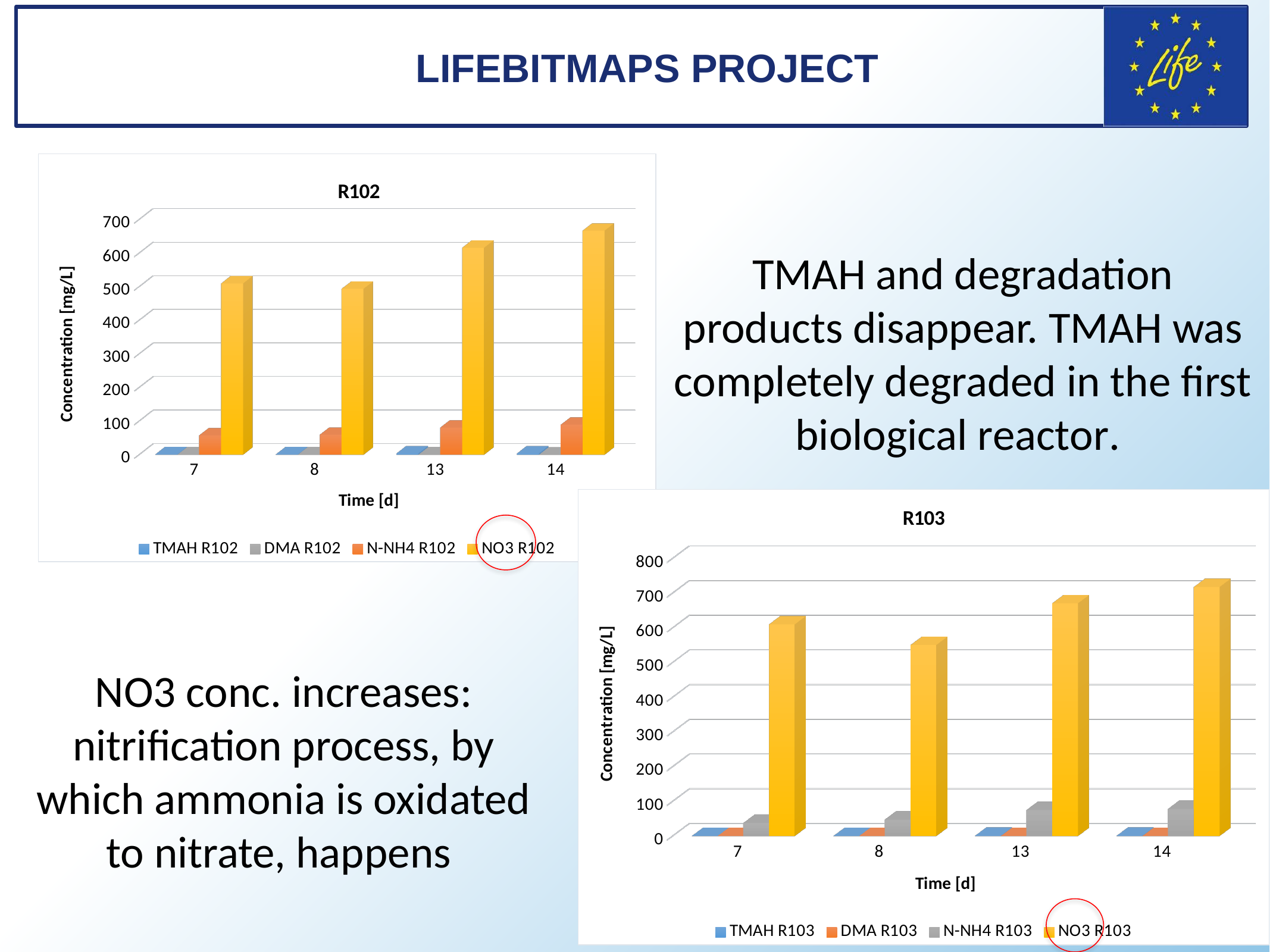
In the R103 chart, at which time is the NO3 R103 value highest? 14 How many time points are shown on the x axis of the R103 chart? 4 In the R103 chart, is the NO3 R103 value at time 8 greater or less than 400? greater In the R103 chart, at which time is the NO3 R103 value lowest? 8 What is the y-axis label of the R103 chart? Concentration [mg/L] What type of chart is the R102 chart? bar chart In the R102 chart, at which time is the NO3 R102 value highest? 14 In the R103 chart, is the NO3 R103 value at time 14 greater or less than 600? greater In the R102 chart, is the NO3 R102 value at time 7 greater or less than 400? greater How many series does the legend of the R102 chart list? 4 In the R102 chart, which is larger at time 14: the N-NH4 R102 value or the TMAH R102 value? N-NH4 R102